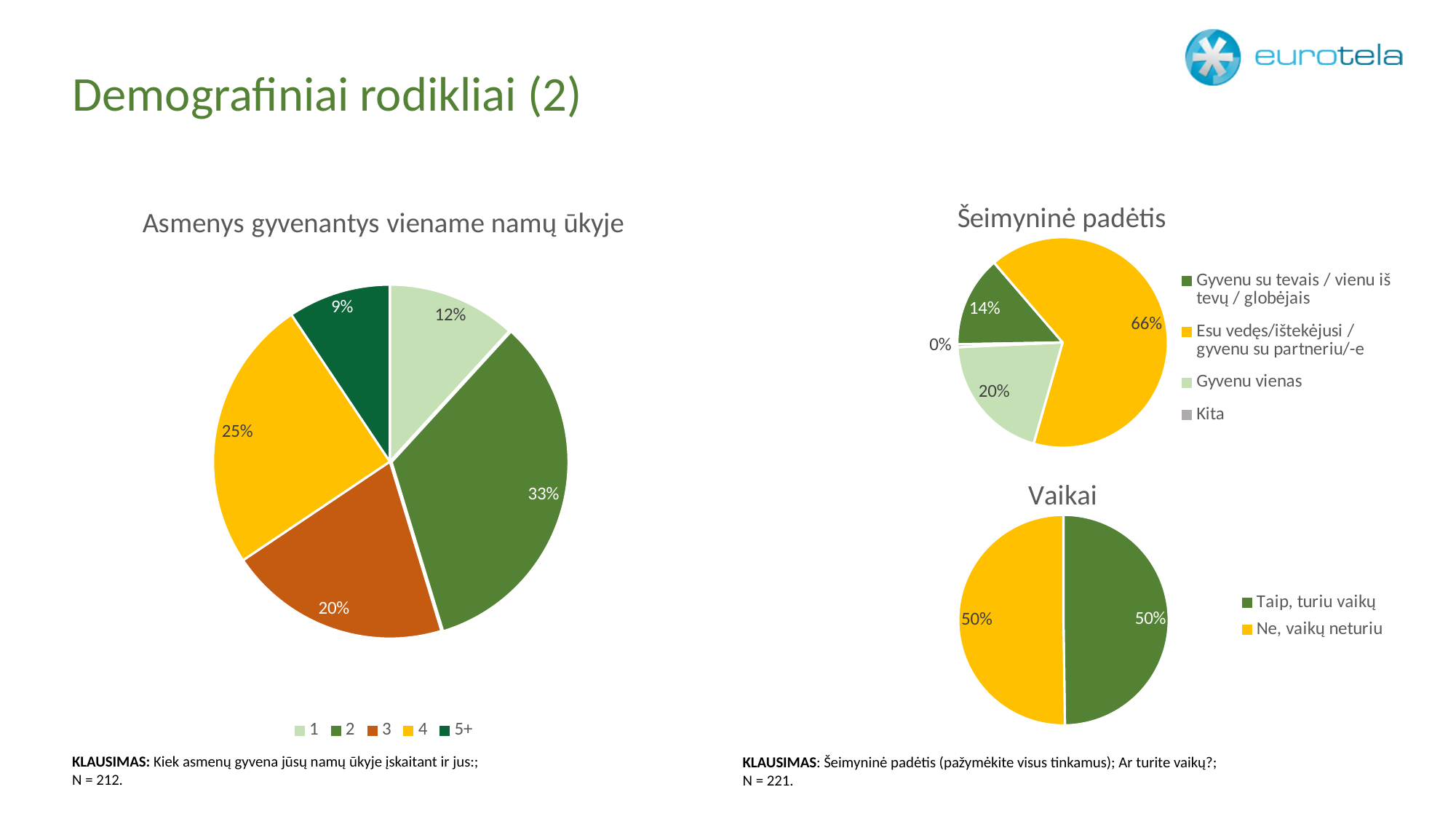
In the 'Šeimyninė padėtis' chart, which category has the smallest share? Kita In the 'Asmenys gyvenantys viename namų ūkyje' chart, which category has the largest share? 2 In the 'Asmenys gyvenantys viename namų ūkyje' chart, what is the value for the '5+' category? 9% What type of chart is 'Asmenys gyvenantys viename namų ūkyje'? Pie chart In the 'Šeimyninė padėtis' chart, which is larger: 'Gyvenu su tevais / vienu iš tevų / globėjais' or 'Gyvenu vienas'? Gyvenu vienas In the 'Asmenys gyvenantys viename namų ūkyje' chart, what is the difference in percentage points between the '4' and '1' categories? 13 In the 'Asmenys gyvenantys viename namų ūkyje' chart, which category has the smallest share? 5+ In the 'Šeimyninė padėtis' chart, what is the share for 'Esu vedęs/ištekėjusi / gyvenu su partneriu/-e'? 66% In the 'Asmenys gyvenantys viename namų ūkyje' chart, how many categories does the legend list? 5 In the 'Vaikai' chart, what is the share for 'Taip, turiu vaikų'? 50% In the 'Šeimyninė padėtis' chart, what is the share for 'Gyvenu vienas'? 20% In the 'Asmenys gyvenantys viename namų ūkyje' chart, what share of households have 2 persons? 33%